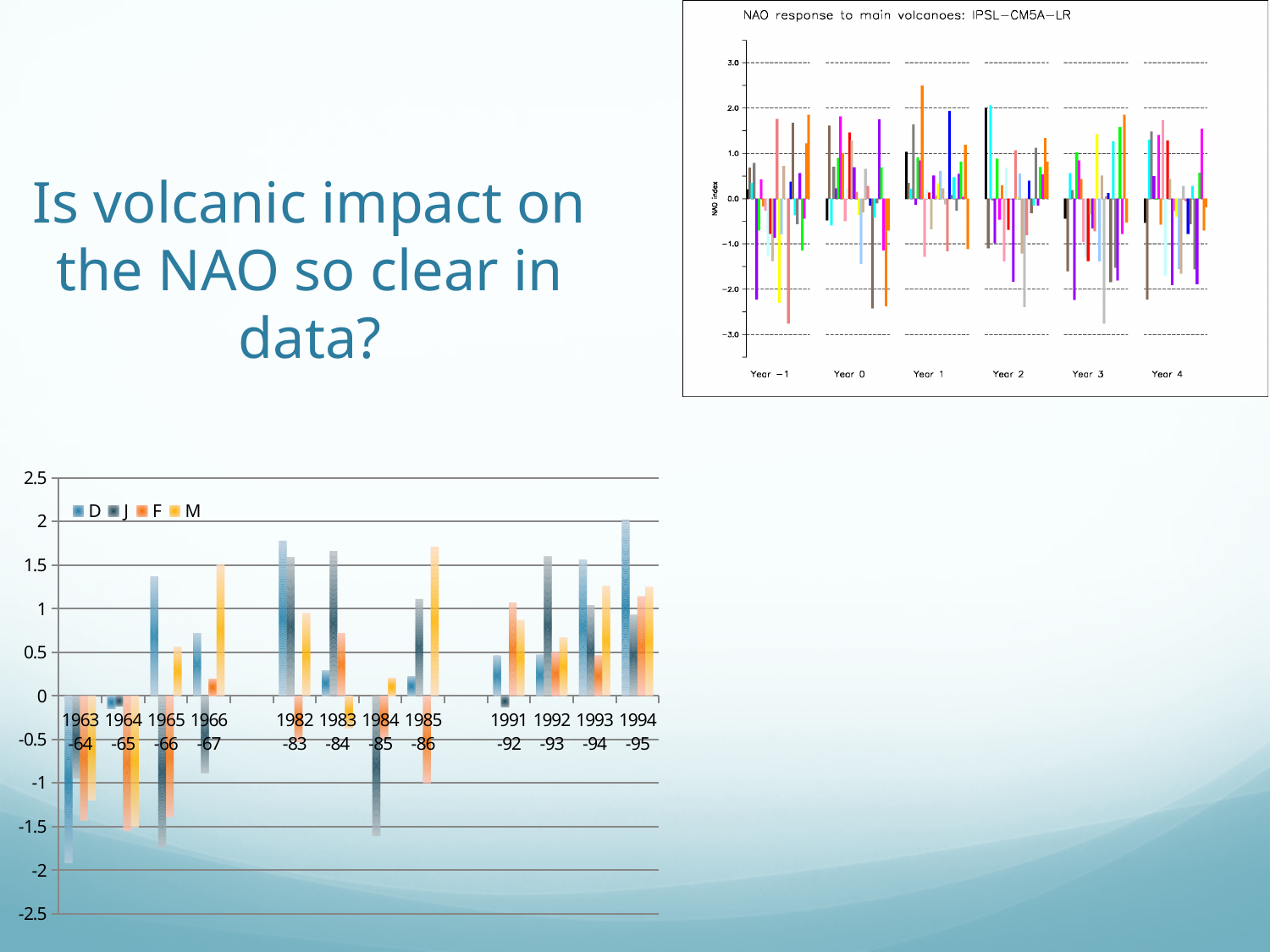
How many series does the legend of the bottom-left chart list? 4 In the bottom-left chart, is the J value for 1965-66 greater or less than -1? less In the bottom-left chart, which winter has the highest D value? 1994-95 In the bottom-left chart, is the D value for 1982-83 greater or less than 1.5? greater In the bottom-left chart, is the M value for 1985-86 greater or less than 1.5? greater What is the title of the chart in the top-right of the slide? NAO response to main volcanoes: IPSL-CM5A-LR How many winter categories (e.g. 1963-64) are shown on the x axis of the bottom-left chart? 12 What kind of chart is the bottom-left chart with the D, J, F, M legend? bar chart In the bottom-left chart, which is larger: the M value for 1985-86 or the M value for 1965-66? 1985-86 In the bottom-left chart, which winter has the lowest D value? 1963-64 How many year groups (Year -1 to Year 4) are shown on the x axis of the top-right chart? 6